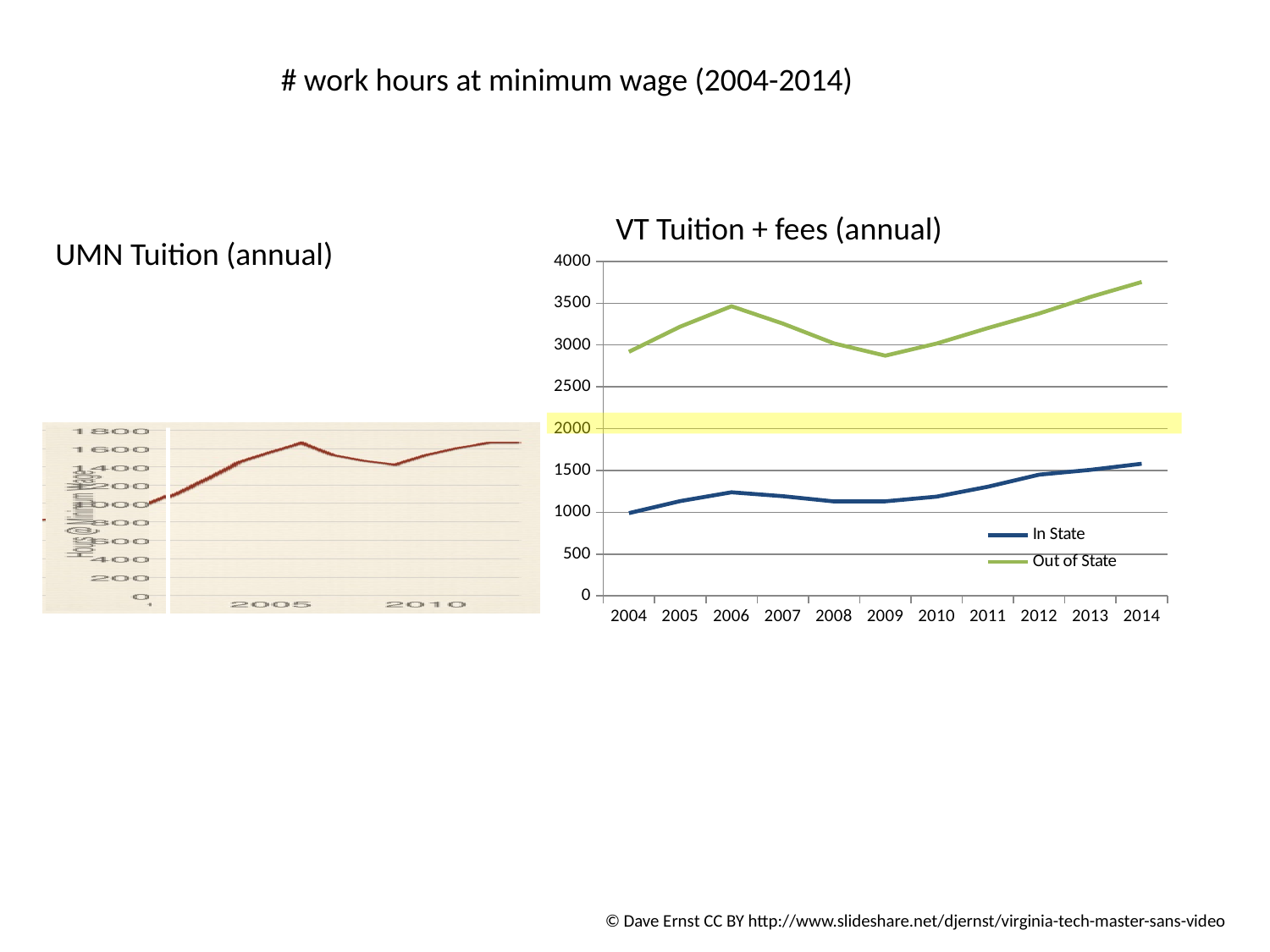
In the "VT Tuition + fees (annual)" chart, does the In State series rise or fall from 2004 to 2014? rise What are the two legend entries in the "VT Tuition + fees (annual)" chart? In State, Out of State What kind of chart is the "VT Tuition + fees (annual)" chart? line chart In the "VT Tuition + fees (annual)" chart, which year has the highest Out of State value? 2014 In the "VT Tuition + fees (annual)" chart, which series has the larger value in 2010, In State or Out of State? Out of State In the "VT Tuition + fees (annual)" chart, is the In State value for 2014 greater or less than 1500? greater In the "VT Tuition + fees (annual)" chart, how many years are shown on the x axis? 11 How many series does the legend of the "VT Tuition + fees (annual)" chart list? 2 In the "VT Tuition + fees (annual)" chart, is the Out of State value for 2014 greater or less than 3500? greater In the "VT Tuition + fees (annual)" chart, is the In State value for 2006 greater or less than 1000? greater In the "VT Tuition + fees (annual)" chart, which year has the lowest In State value? 2004